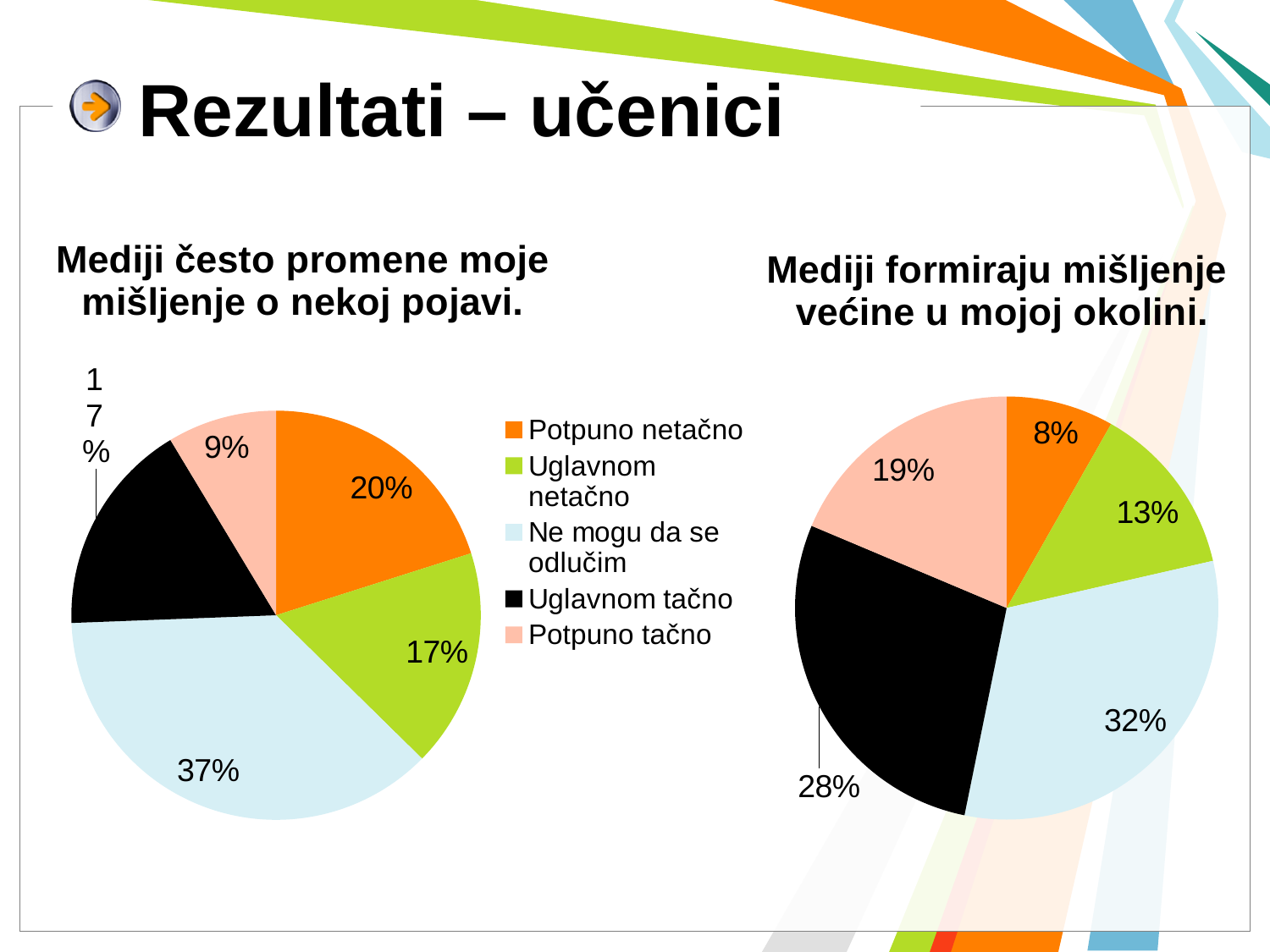
How many entries does the legend on the slide list? 5 In the chart "Mediji često promene moje mišljenje o nekoj pojavi.", what percentage is "Potpuno tačno"? 9% In the chart "Mediji formiraju mišljenje većine u mojoj okolini.", what percentage is "Uglavnom tačno"? 28% What type of chart is used on the slide for "Mediji često promene moje mišljenje o nekoj pojavi."? Pie chart In the chart "Mediji često promene moje mišljenje o nekoj pojavi.", which category has the largest share? Ne mogu da se odlučim In the chart "Mediji često promene moje mišljenje o nekoj pojavi.", which category has the smallest share? Potpuno tačno In the chart "Mediji često promene moje mišljenje o nekoj pojavi.", what is the difference between "Potpuno netačno" and "Potpuno tačno"? 11% How many slices does the chart "Mediji formiraju mišljenje većine u mojoj okolini." have? 5 In the chart "Mediji često promene moje mišljenje o nekoj pojavi.", what percentage is "Ne mogu da se odlučim"? 37% In the chart "Mediji formiraju mišljenje većine u mojoj okolini.", what percentage is "Potpuno netačno"? 8% In the chart "Mediji formiraju mišljenje većine u mojoj okolini.", which category has the largest share? Ne mogu da se odlučim In the chart "Mediji formiraju mišljenje većine u mojoj okolini.", which is larger, "Uglavnom netačno" or "Potpuno tačno"? Potpuno tačno